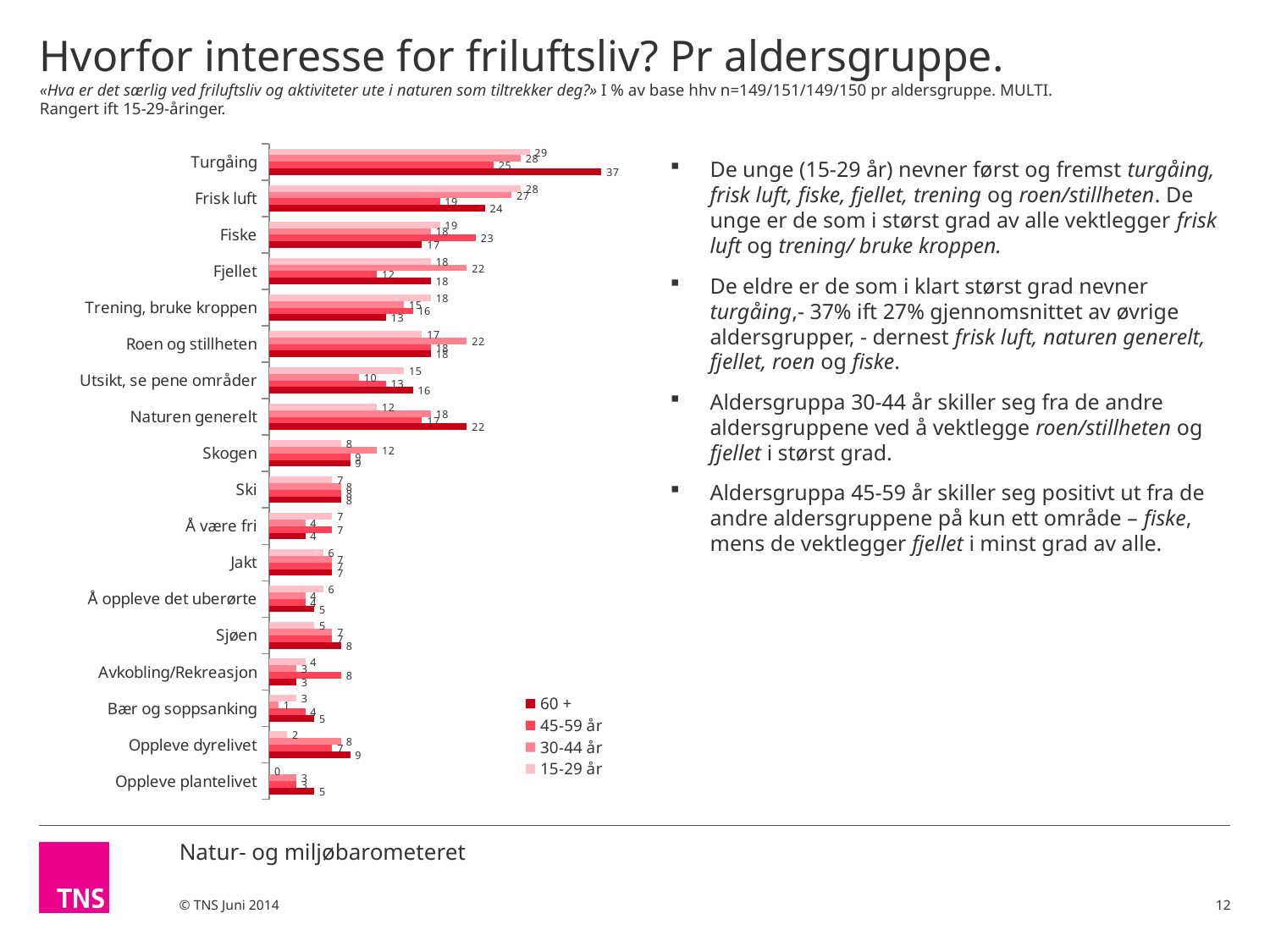
What kind of chart is shown on the slide? Bar chart What is the value for the 60 + series for Turgåing? 37 How many categories are shown on the chart? 18 What is the value for the 45-59 år series for Fiske? 23 Which category has the lowest value for the 15-29 år series? Oppleve plantelivet How many series does the legend list? 4 What is the value for the 15-29 år series for Frisk luft? 28 What is the difference between the 60 + value and the 45-59 år value for Turgåing? 12 What is the value for the 60 + series for Naturen generelt? 22 Which category has the highest value for the 60 + series? Turgåing For Fjellet, which is larger: the 30-44 år value or the 45-59 år value? 30-44 år Which series is listed first in the legend? 60 +